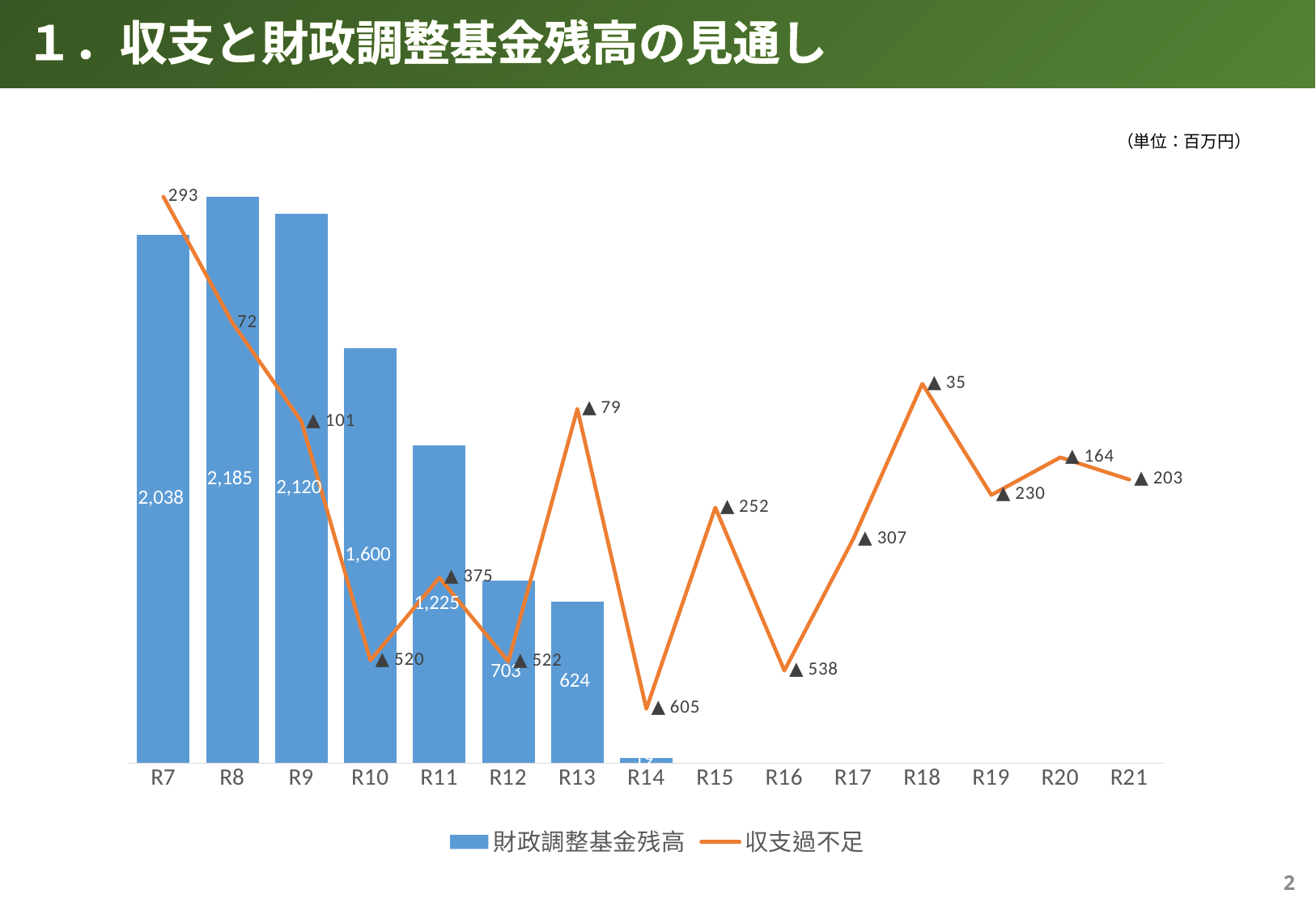
Which year has the highest 財政調整基金残高 bar? R8 How many series does the legend list? 2 Which year has the lowest point on the 収支過不足 line? R14 What unit is stated for the chart values? 百万円 What is the value of 収支過不足 for R14? ▲ 605 What kind of chart is this? Combined bar and line chart Do the 財政調整基金残高 bars rise or fall from R9 to R14? Fall What is the value of 財政調整基金残高 for R10? 1,600 What is the difference between the 財政調整基金残高 values for R8 and R7? 147 How many years are shown on the x axis? 15 What is the value of 収支過不足 for R7? 293 Which is larger, the 財政調整基金残高 for R12 or for R13? R12